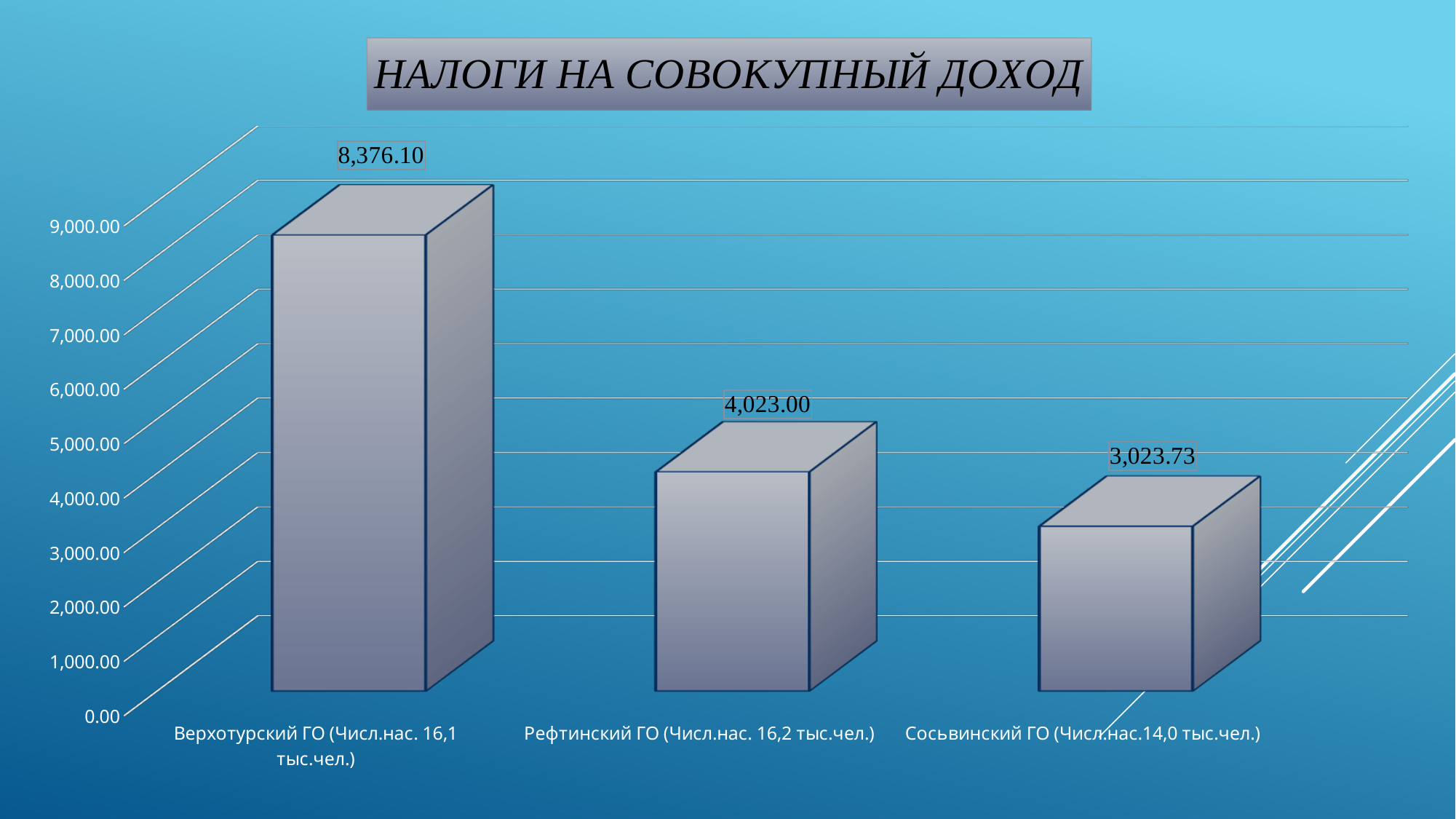
What is the value for Верхотурский ГО? 8,376.10 Which category has the lowest value? Сосьвинский ГО What is the value for Рефтинский ГО? 4,023.00 What is the value for Сосьвинский ГО? 3,023.73 What kind of chart is shown on the slide? bar chart Which is larger, the value for Рефтинский ГО or the value for Сосьвинский ГО? Рефтинский ГО What is the difference between the values for Верхотурский ГО and Рефтинский ГО? 4,353.10 What is the title of the chart? НАЛОГИ НА СОВОКУПНЫЙ ДОХОД What is the difference between the values for Рефтинский ГО and Сосьвинский ГО? 999.27 How many categories are shown in the chart? 3 Is the value for Верхотурский ГО greater or less than 8,000.00? greater Which category has the highest value? Верхотурский ГО